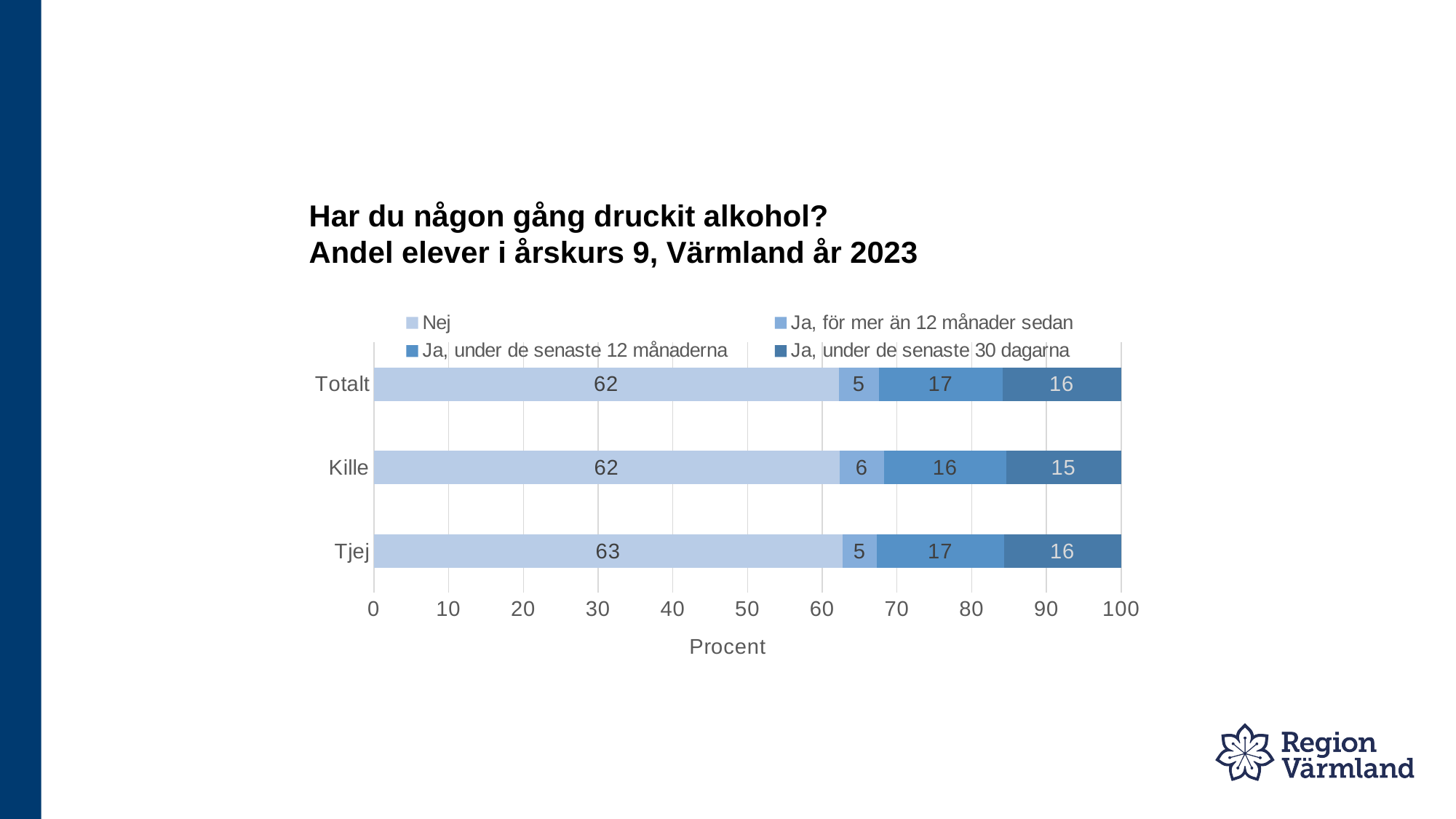
What is the value for "Nej" for Tjej? 63 What is the value for "Ja, under de senaste 30 dagarna" for Kille? 15 Which is larger: the "Ja, för mer än 12 månader sedan" value for Kille or for Tjej? Kille What kind of chart is shown? Stacked bar chart Which category has the highest value for "Nej"? Tjej Which category has the lowest value for "Ja, under de senaste 30 dagarna"? Kille What is the total of the stacked bar for Totalt? 100 What is the value for "Ja, under de senaste 12 månaderna" for Kille? 16 How many categories are shown on the y axis? 3 What is the value for "Ja, för mer än 12 månader sedan" for Totalt? 5 What is the difference between the "Ja, under de senaste 12 månaderna" values for Tjej and Kille? 1 How many series does the legend list? 4